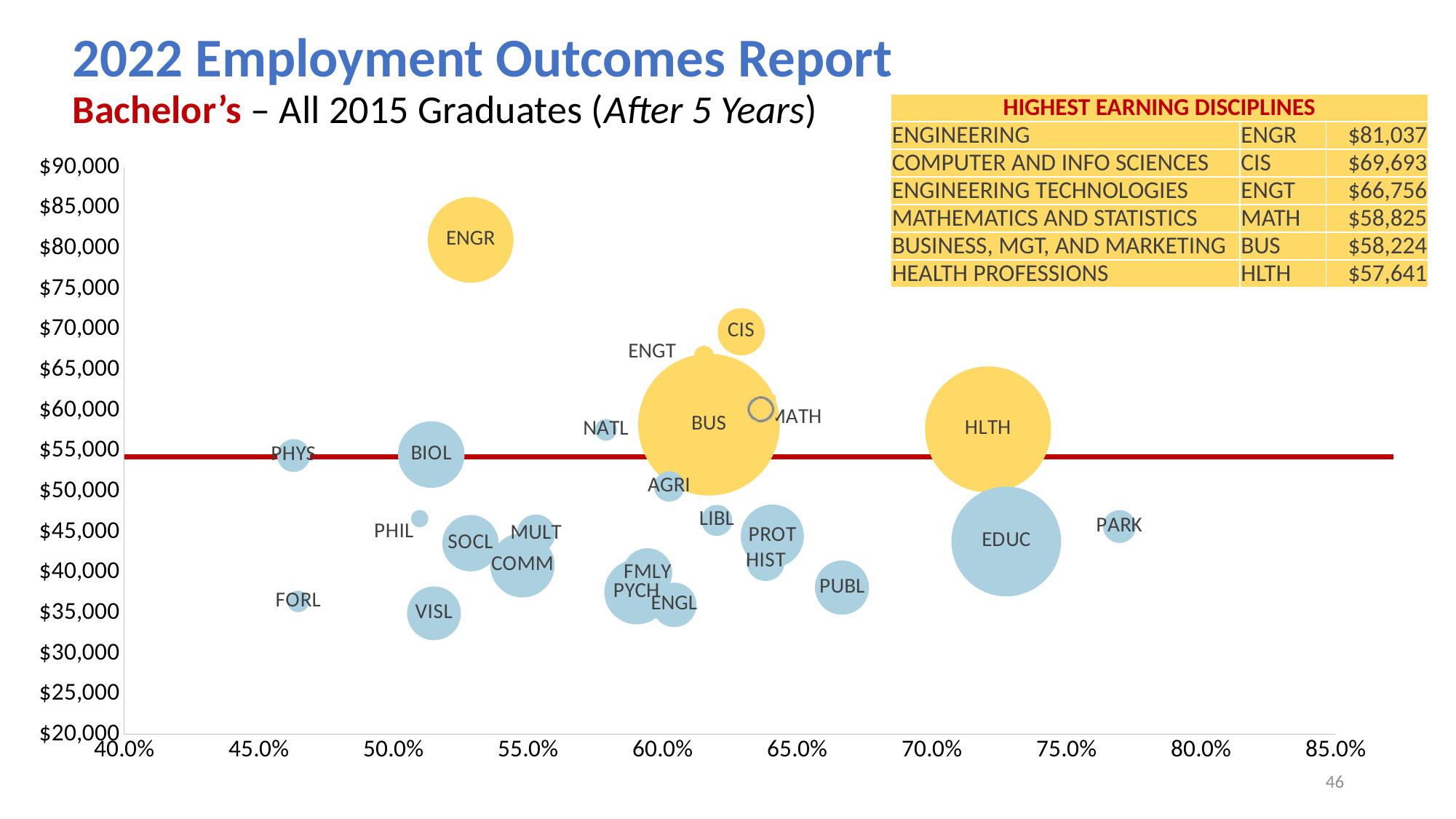
What colour are the bubbles for the highest earning disciplines such as ENGR, CIS, BUS and HLTH? yellow What are the earnings listed for Business, Mgt, and Marketing (BUS)? $58,224 Which has higher earnings, ENGR or HLTH? ENGR Is the earnings value for EDUC greater or less than $50,000? less What kind of chart is shown on the slide? bubble chart According to the Highest Earning Disciplines table, what are the earnings for Computer and Info Sciences (CIS)? $69,693 Is the employment rate (x-axis value) for PARK greater or less than 75.0%? greater Which discipline has the highest earnings on the chart? ENGR According to the Highest Earning Disciplines table, what are the earnings for Engineering (ENGR)? $81,037 What is the difference in earnings between MATH and BUS? $601 What is the difference in earnings between ENGR and CIS? $11,344 How many disciplines are listed in the Highest Earning Disciplines table? 6